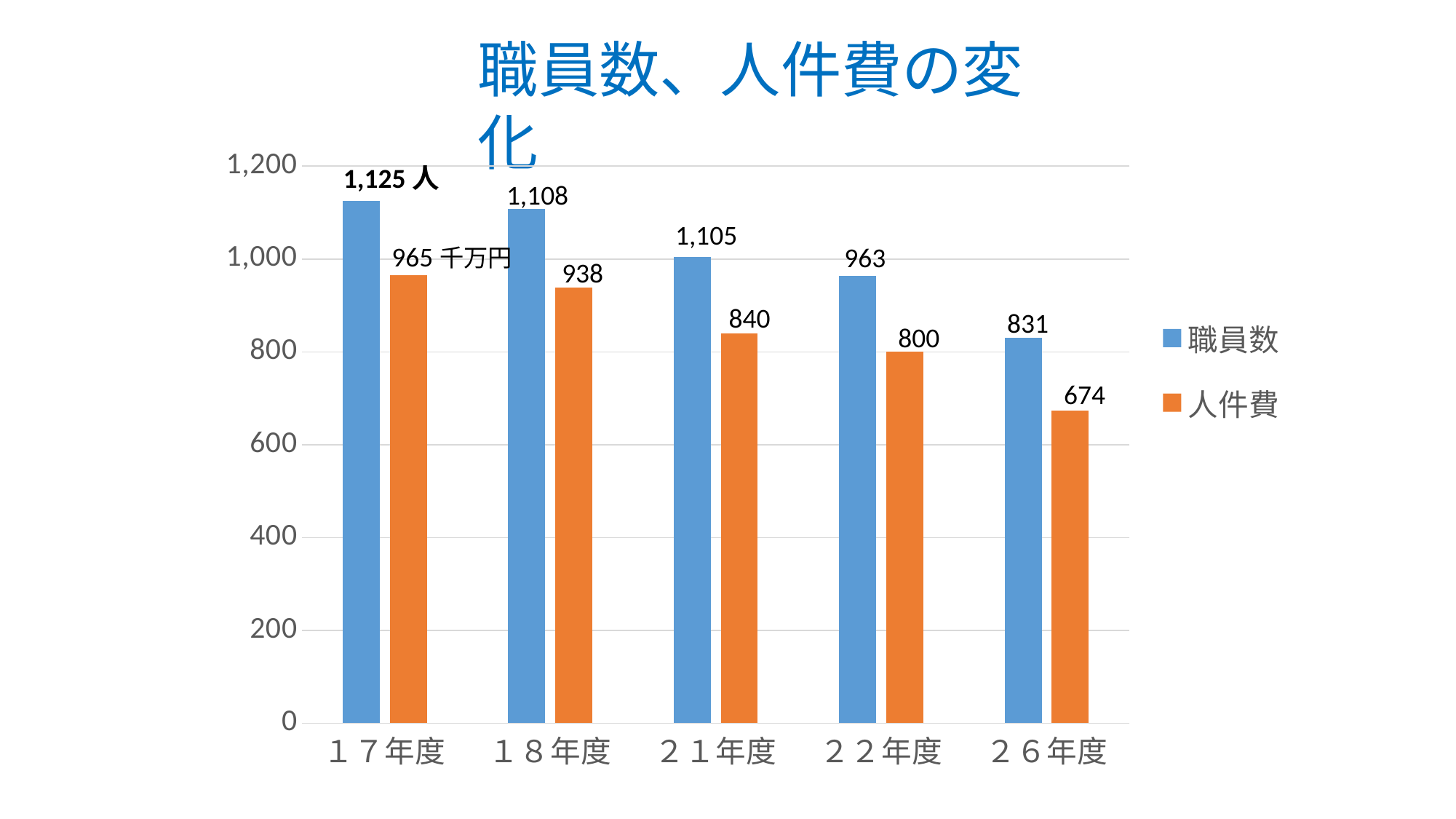
What kind of chart is shown on the slide? Bar chart Which year has the highest 職員数? １７年度 What is the 職員数 value for １７年度? 1,125 人 What is the difference between the 人件費 for ２２年度 and ２６年度? 126 Which year has the lowest 人件費? ２６年度 What is the 人件費 value for ２６年度? 674 In ２２年度, which is larger, 職員数 or 人件費? 職員数 What is the 人件費 value for １８年度? 938 How many years are shown on the x axis? 5 How many series does the legend list? 2 What is the 職員数 value for ２２年度? 963 What is the difference between the 職員数 for １７年度 and ２６年度? 294